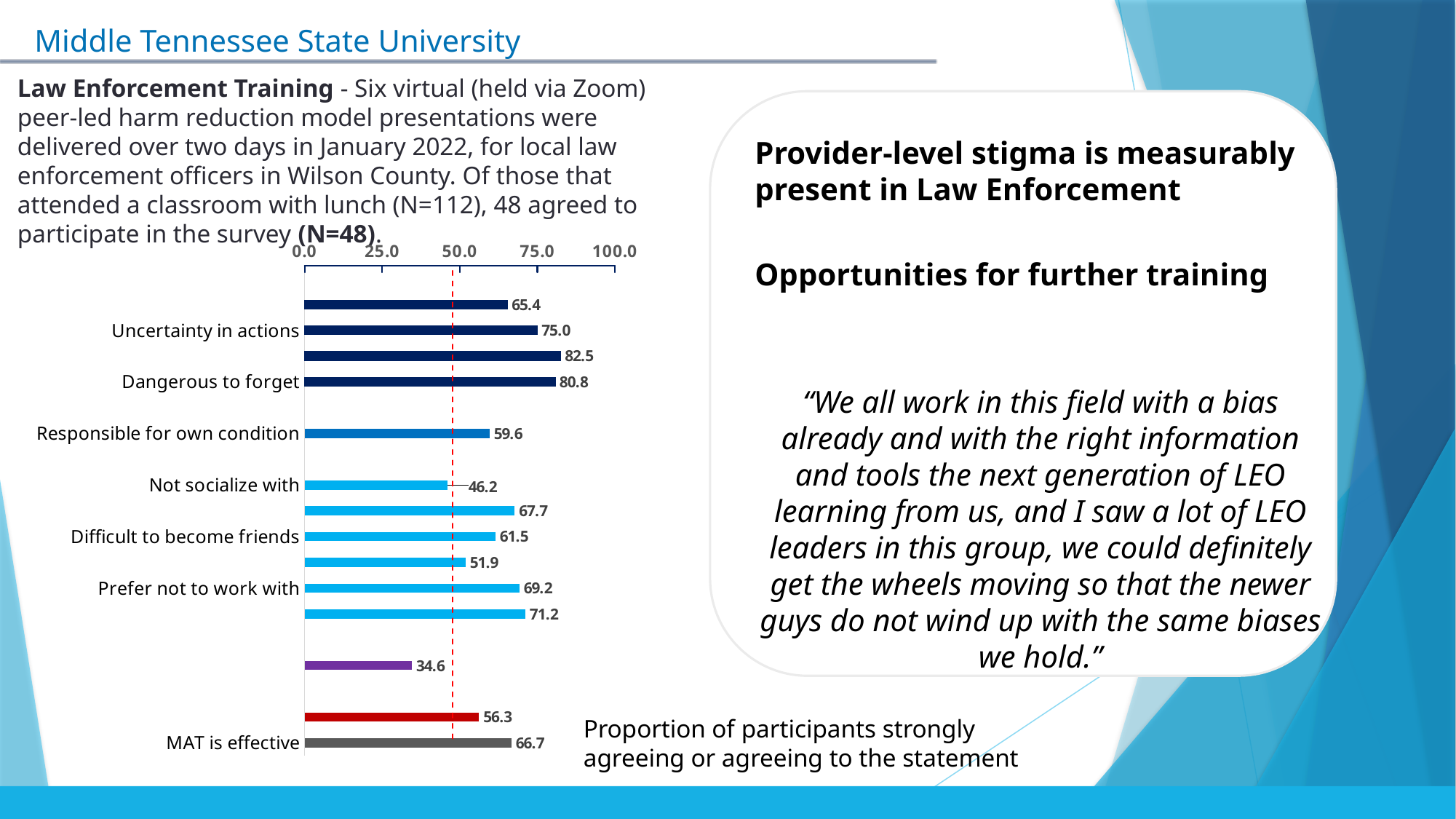
Which is larger, the value for "Prefer not to work with" or the value for "Difficult to become friends"? Prefer not to work with What is the highest value shown on the chart? 82.5 What is the value for "Responsible for own condition"? 59.6 What kind of chart is shown on the slide? bar chart What is the value for "MAT is effective"? 66.7 What is the value for "Uncertainty in actions"? 75.0 What is the difference between the values for "Dangerous to forget" and "Uncertainty in actions"? 5.8 What is the value for "Not socialize with"? 46.2 How many bars are plotted on the chart? 14 What is the lowest value shown on the chart? 34.6 What is the value for "Dangerous to forget"? 80.8 What is the value of the purple bar? 34.6